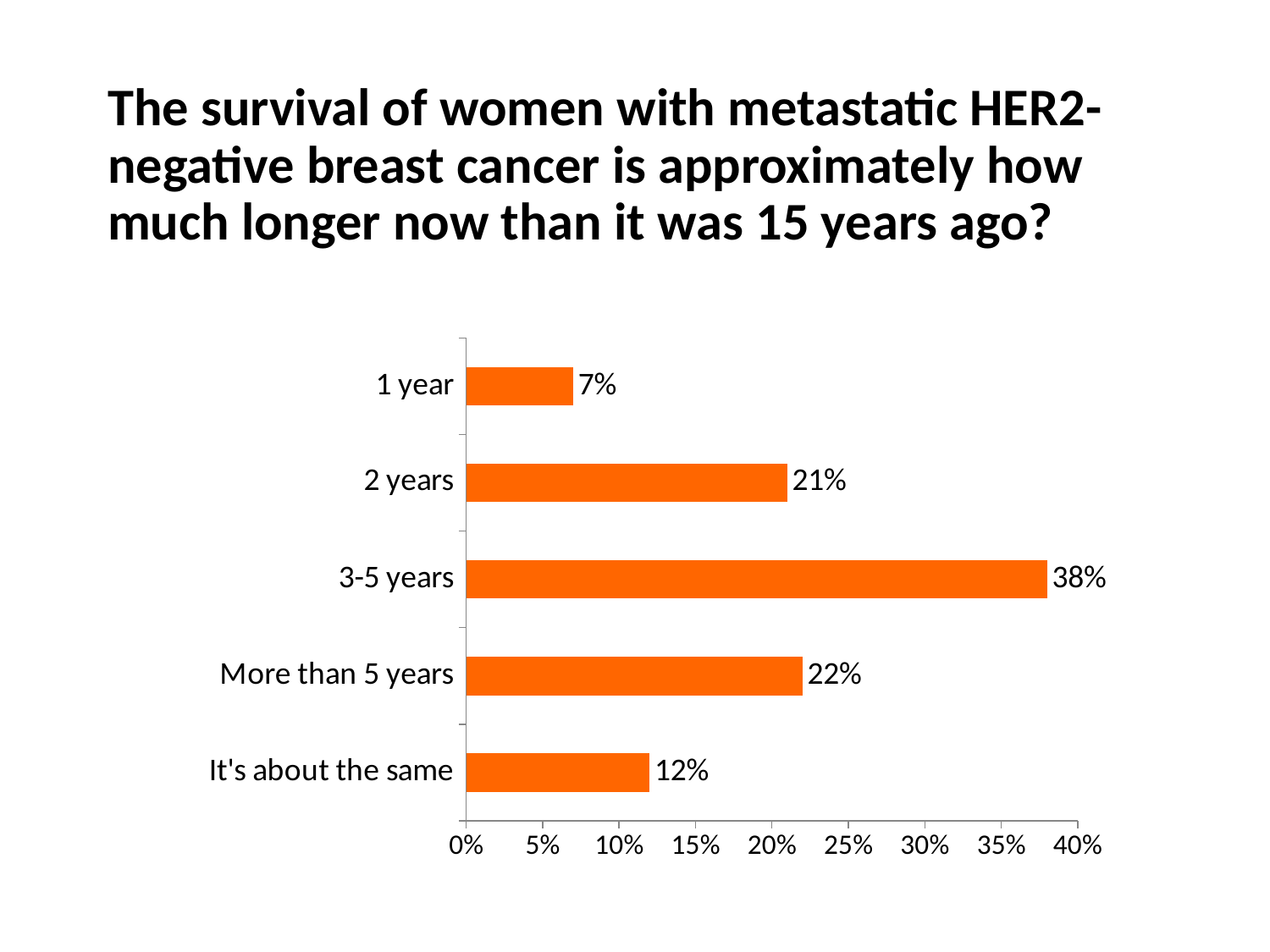
Which response category has the highest value? 3-5 years How many response categories are shown in the chart? 5 What percentage of respondents answered "3-5 years"? 38% What is the difference between "More than 5 years" and "It's about the same"? 10% Is the value for "More than 5 years" greater or less than 20%? greater What is the difference between the values for "3-5 years" and "2 years"? 17% Which response category has the lowest value? 1 year Which is larger, the value for "2 years" or the value for "It's about the same"? 2 years What percentage chose "1 year"? 7% What kind of chart is shown on the slide? Bar chart What is the value for "It's about the same"? 12% What is the maximum value shown on the horizontal axis? 40%